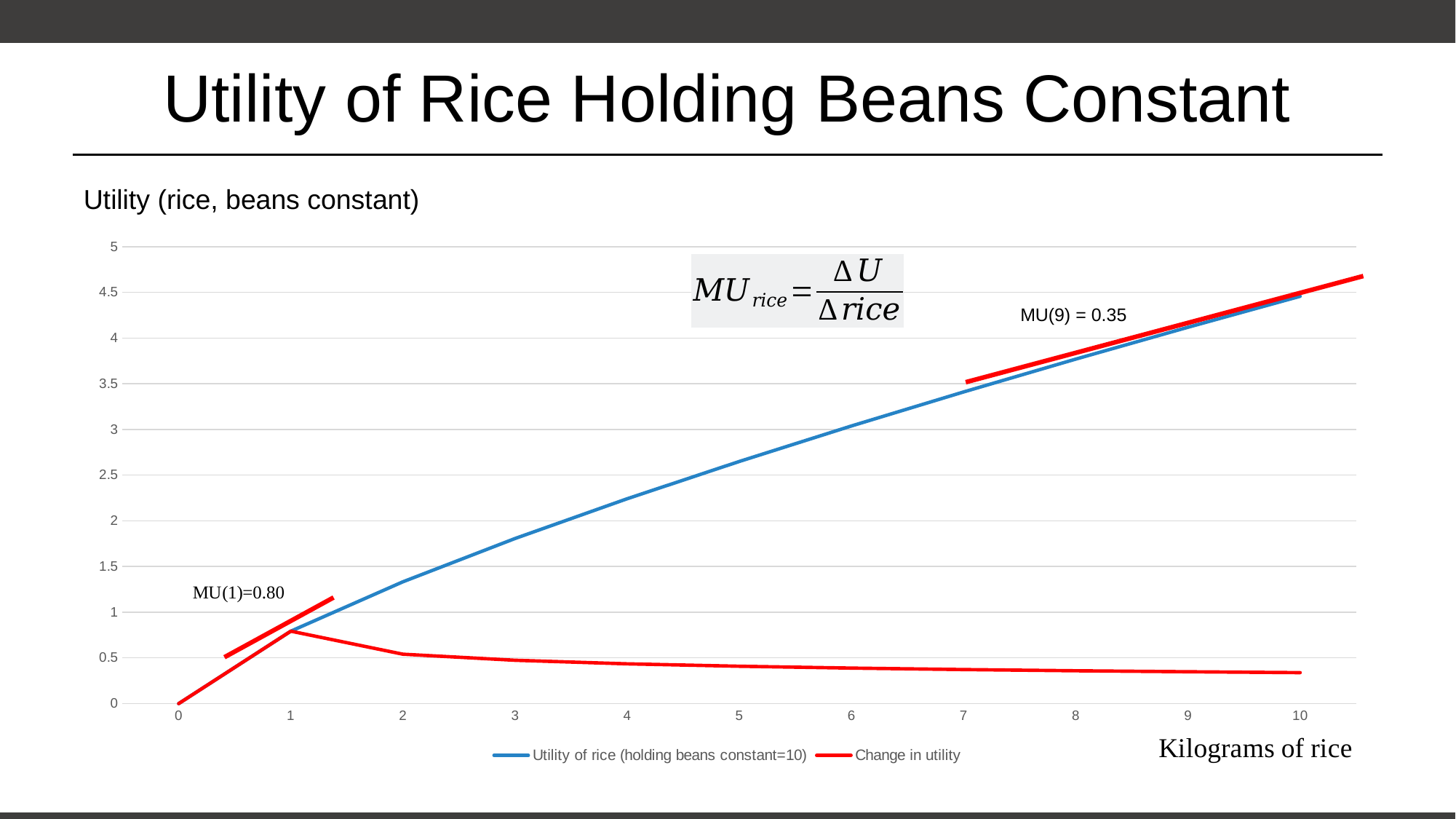
Does the 'Utility of rice' series rise or fall as kilograms of rice increase from 0 to 10? rise Does the 'Change in utility' series rise or fall as kilograms of rice increase from 1 to 10? fall What is the label on the x axis of the chart? Kilograms of rice What are the two series named in the legend? Utility of rice (holding beans constant=10) and Change in utility What value does the slide give for MU(9)? 0.35 What kind of chart is shown on the slide? line chart What value does the slide give for MU(1)? 0.80 How many tick marks are labelled on the x axis? 11 How many series does the legend list? 2 Is the value of 'Utility of rice' at 10 kilograms greater or less than 4? greater At 5 kilograms of rice, which series has the higher value: 'Utility of rice' or 'Change in utility'? Utility of rice Is the value of 'Change in utility' at 10 kilograms greater or less than 0.5? less